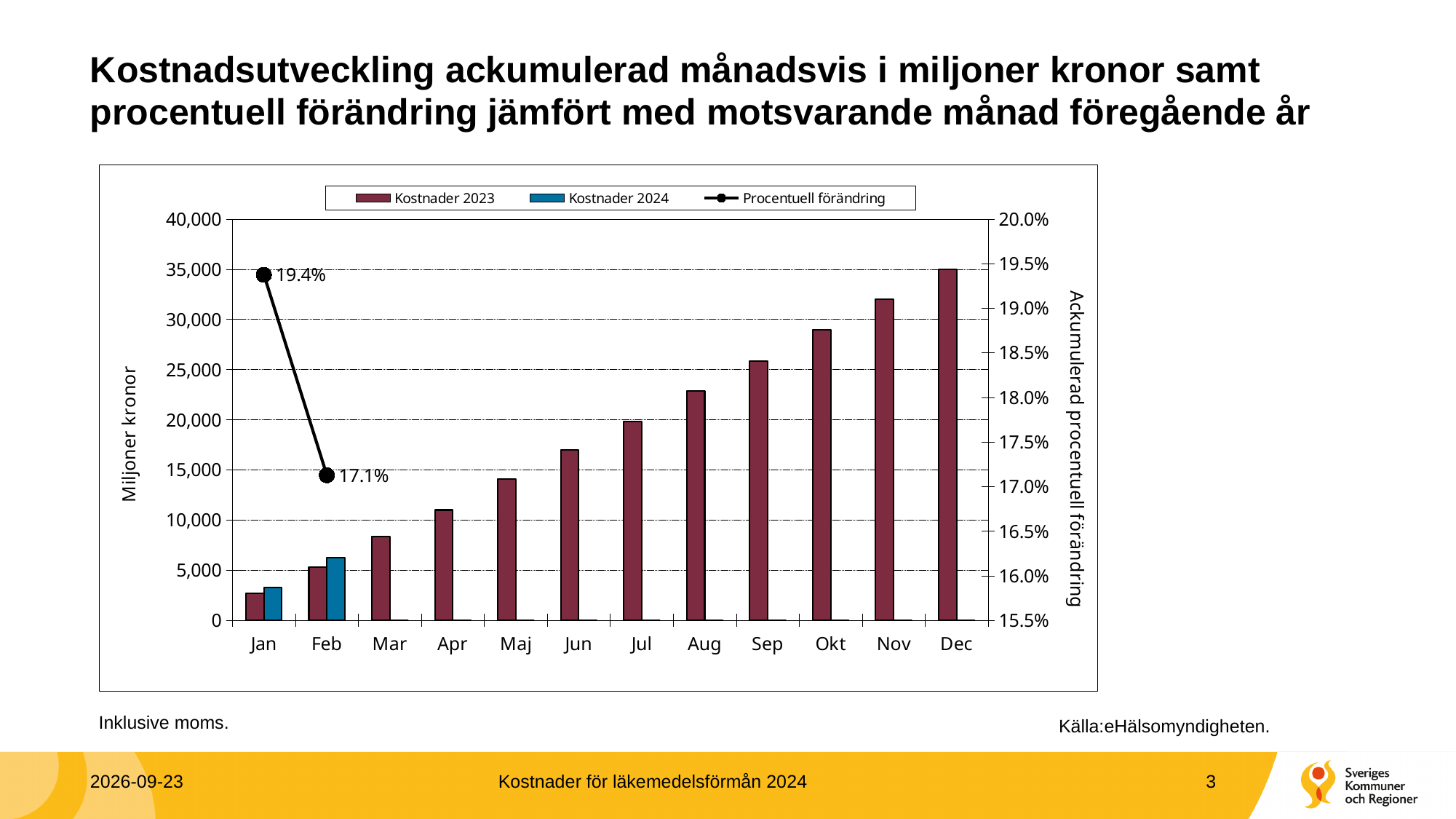
Does the Procentuell förändring line rise or fall from Jan to Feb? fall Do the Kostnader 2023 bars rise or fall from Jan to Dec? rise Is the Kostnader 2023 value for Dec greater or less than 30,000? greater What is the Procentuell förändring value for Jan? 19.4% What is the Procentuell förändring value for Feb? 17.1% In Feb, which is larger: Kostnader 2023 or Kostnader 2024? Kostnader 2024 By how many percentage points does Procentuell förändring differ between Jan and Feb? 2.3 percentage points How many series does the legend list? 3 Is the Kostnader 2023 value for Mar greater or less than 10,000? less Which month has the highest Kostnader 2023 bar? Dec Which month has the lowest Kostnader 2023 bar? Jan How many months are shown on the x axis? 12